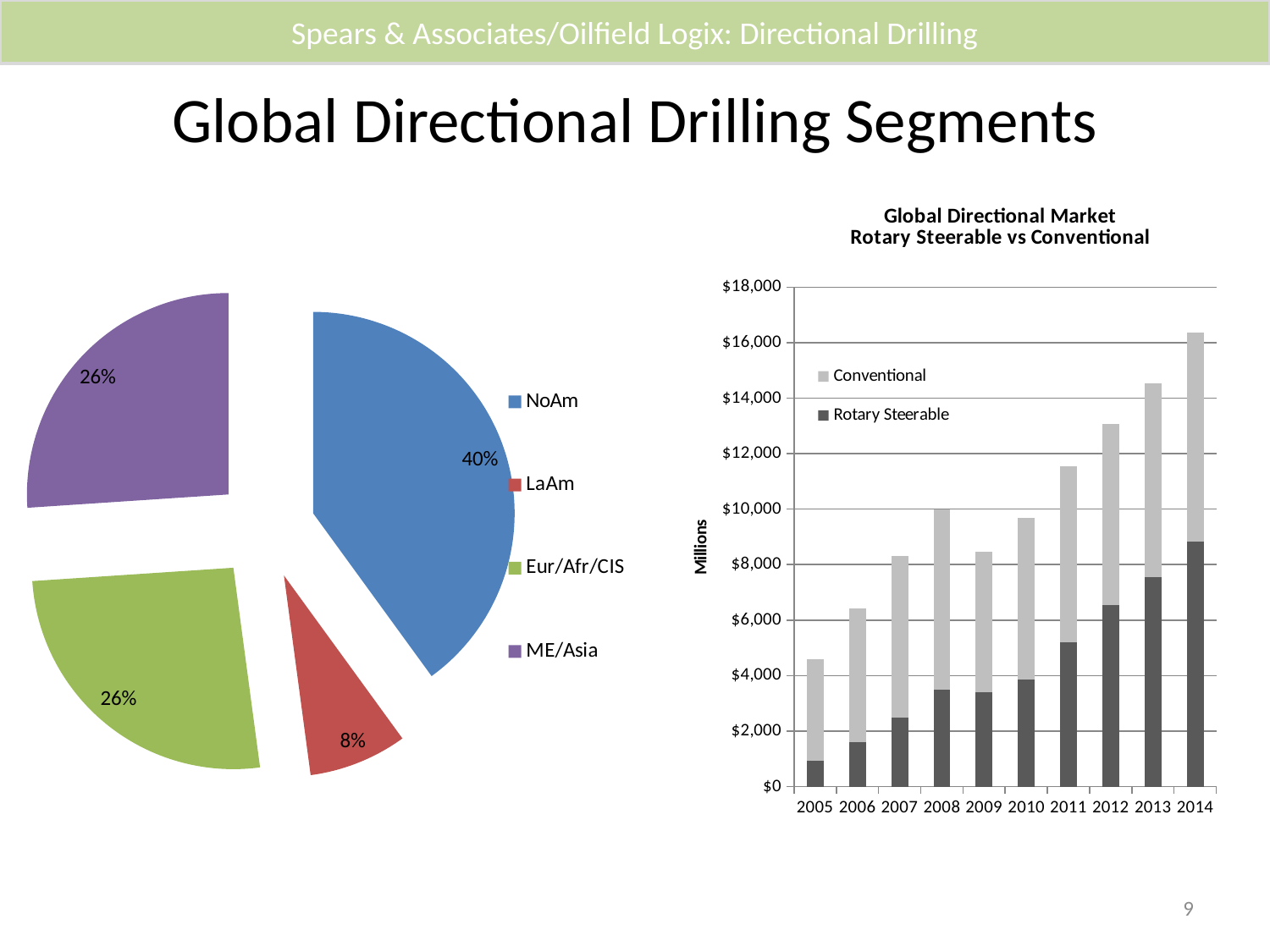
How many series does the legend of the 'Global Directional Market Rotary Steerable vs Conventional' chart list? 2 In the pie chart on the left, which region has the largest slice? NoAm In the pie chart on the left, which region has the smallest slice? LaAm In the pie chart on the left, what share does NoAm have? 40% What kind of chart is the 'Global Directional Market Rotary Steerable vs Conventional' chart? Stacked bar chart In the 'Global Directional Market Rotary Steerable vs Conventional' chart, do the total bar heights generally rise or fall from 2005 to 2014? Rise In the 'Global Directional Market Rotary Steerable vs Conventional' chart, is the total for 2014 greater or less than $14,000? greater In the 'Global Directional Market Rotary Steerable vs Conventional' chart, is the Rotary Steerable value for 2005 greater or less than $2,000? less In the pie chart on the left, what share does LaAm have? 8% How many slices does the pie chart on the left have? 4 In the pie chart on the left, what share does Eur/Afr/CIS have? 26% How many years are shown on the x axis of the 'Global Directional Market Rotary Steerable vs Conventional' chart? 10